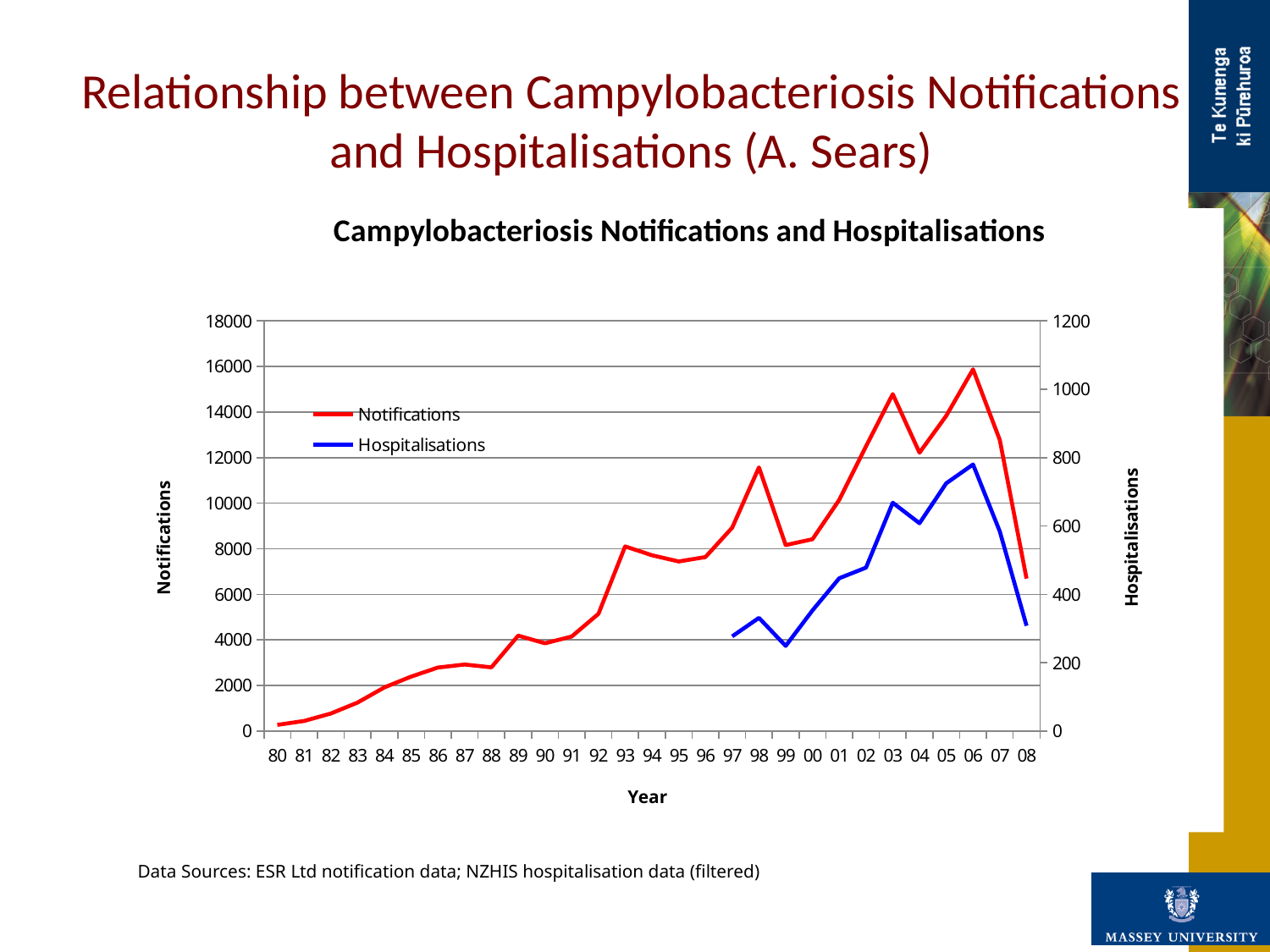
What kind of chart is shown on the slide? Line chart Is the value for Hospitalisations in 99 greater or less than 400? less Do Notifications rise or fall from 06 to 08? Fall In which year do Notifications reach their highest value? 06 How many series does the legend list? 2 What is the label of the right-hand vertical axis? Hospitalisations How many years are shown along the x axis? 29 Is the value for Notifications in 06 greater or less than 14000? greater Which year has the higher Notifications value, 03 or 04? 03 In which year do Hospitalisations reach their highest value? 06 In which year are Notifications at their lowest? 80 Is the value for Notifications in 08 greater or less than 8000? less